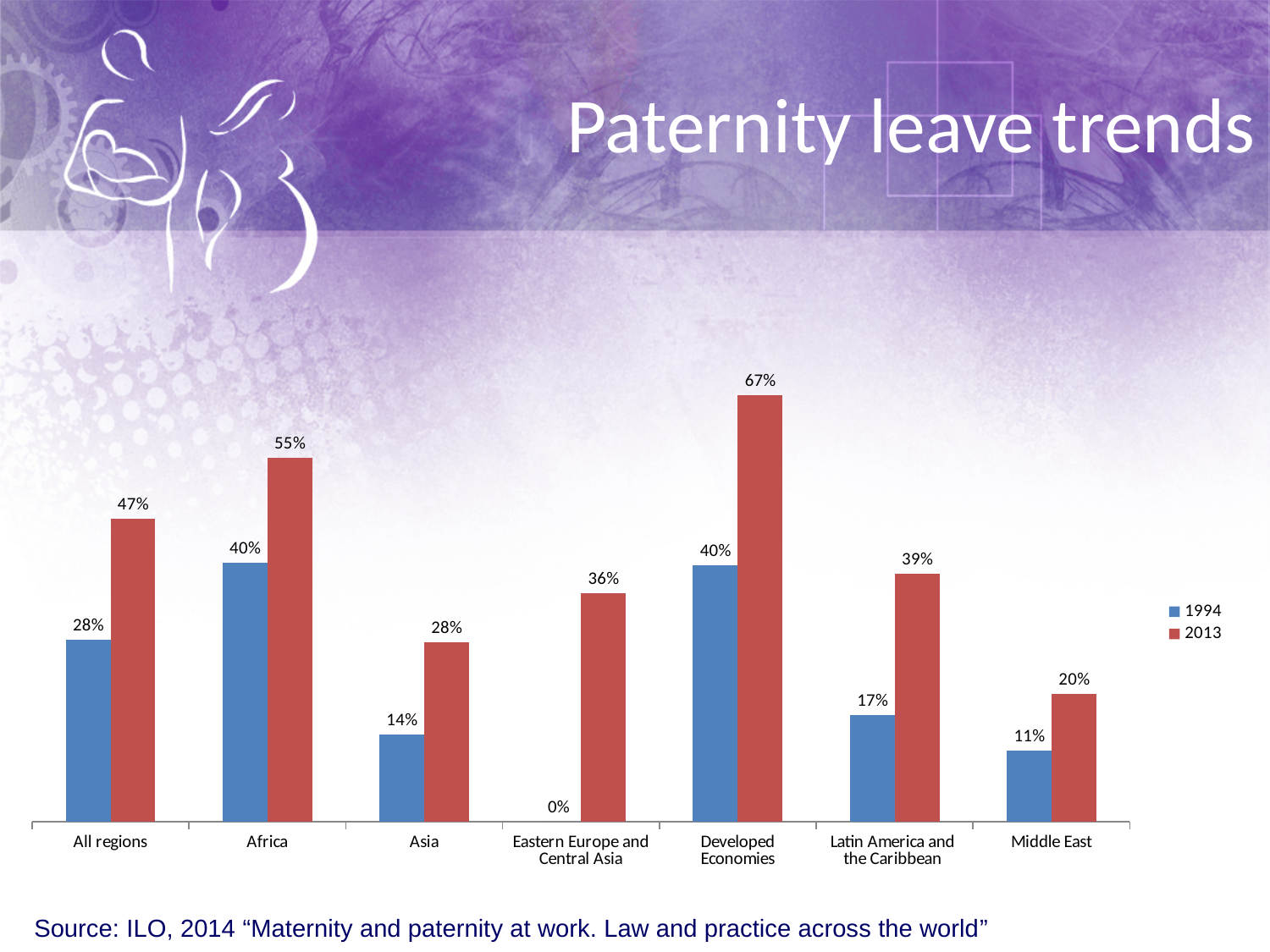
What is the 1994 value for Asia? 14% Which category has the highest 2013 value? Developed Economies Which category has the lowest 1994 value? Eastern Europe and Central Asia Which is larger: the 2013 value for Latin America and the Caribbean or the 2013 value for Eastern Europe and Central Asia? Latin America and the Caribbean What is the 2013 value for Developed Economies? 67% How many categories are shown on the x axis? 7 What is the 1994 value for Eastern Europe and Central Asia? 0% Which colour represents the 2013 series? Red What is the difference between the 2013 and 1994 values for Africa? 15% What is the title of the slide? Paternity leave trends What kind of chart is shown on the slide? Bar chart How many series does the legend list? 2